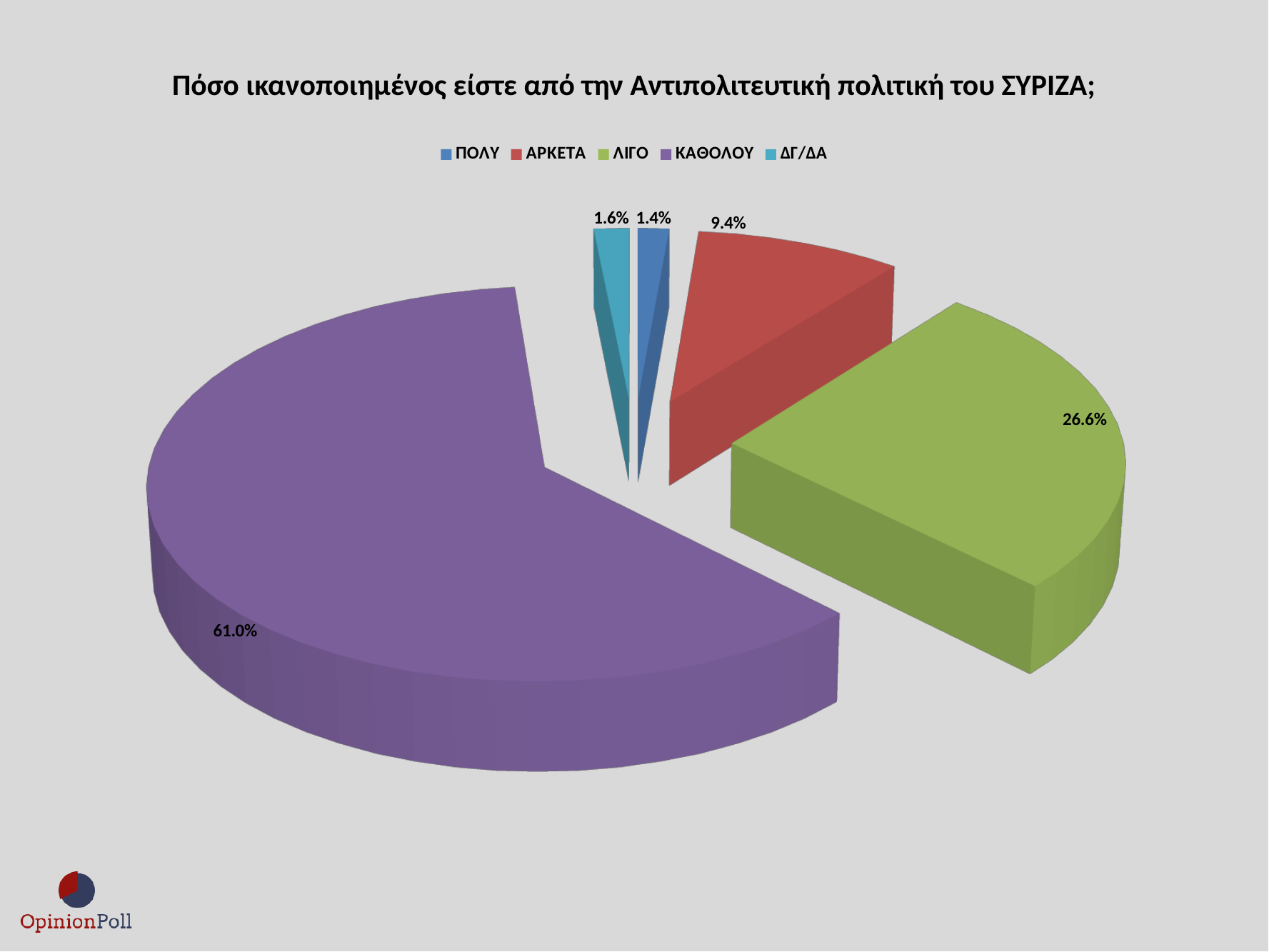
What percentage of respondents answered ΑΡΚΕΤΑ? 9.4% How many categories does the legend list? 5 What percentage of respondents answered ΚΑΘΟΛΟΥ? 61.0% Which is larger, the share for ΑΡΚΕΤΑ or the share for ΛΙΓΟ? ΛΙΓΟ What percentage of respondents answered ΛΙΓΟ? 26.6% What percentage of respondents answered ΔΓ/ΔΑ? 1.6% What kind of chart is shown on the slide? Pie chart Which response category has the largest share of the pie? ΚΑΘΟΛΟΥ What percentage of respondents answered ΠΟΛΥ? 1.4% What is the difference in percentage points between ΚΑΘΟΛΟΥ and ΛΙΓΟ? 34.4 What colour represents ΚΑΘΟΛΟΥ in the chart? Purple Which response category has the smallest share of the pie? ΠΟΛΥ